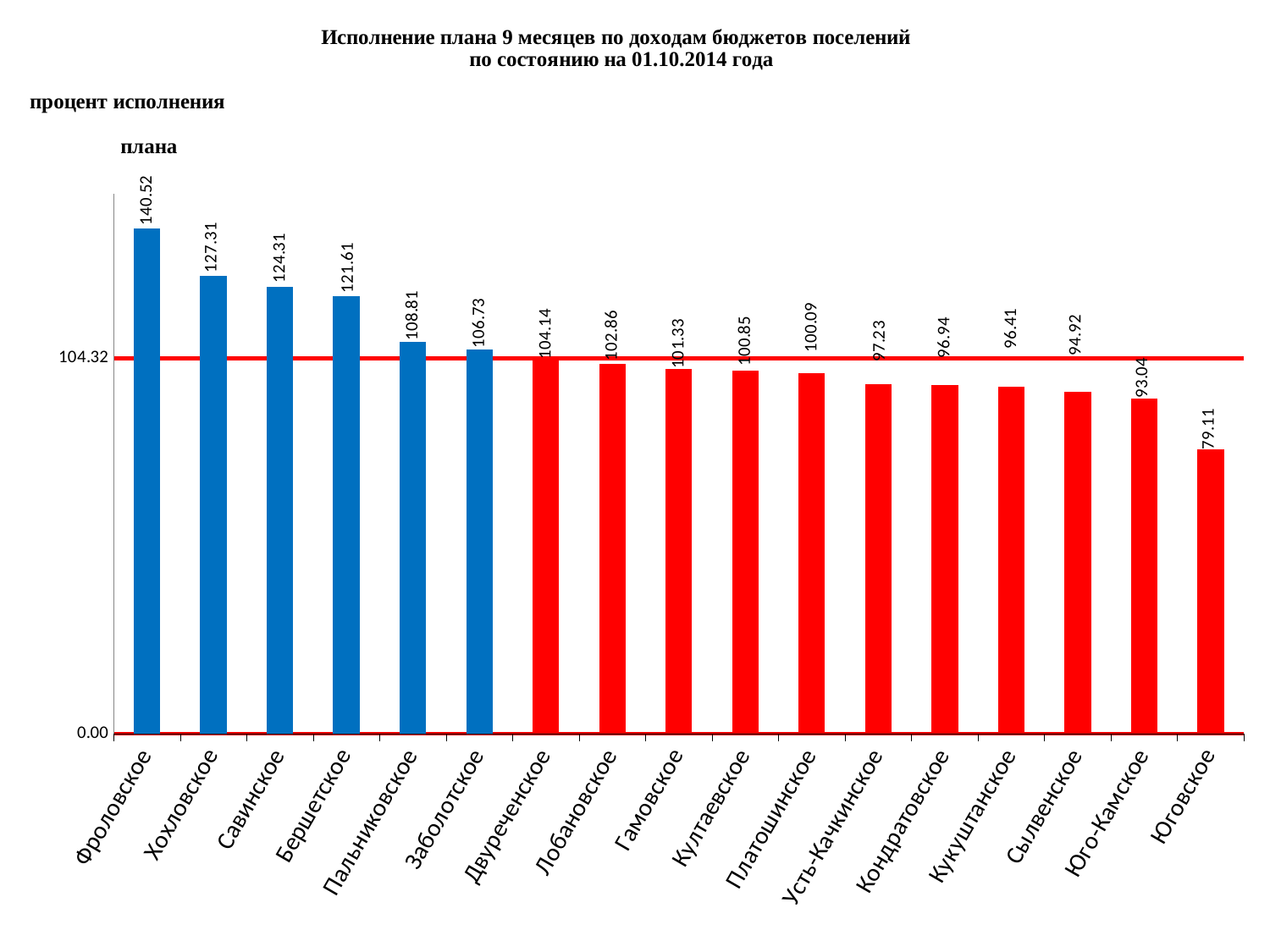
What is the difference between the values for Фроловское and Юговское? 61.41 What value is marked by the horizontal red line across the chart? 104.32 What is the value for Двуреченское? 104.14 How many categories are shown on the x axis? 17 Which category has the lowest value? Юговское What is the value for Фроловское? 140.52 What kind of chart is this? bar chart Which is larger, the value for Бершетское or the value for Пальниковское? Бершетское Which category has the highest value? Фроловское What is the difference between the values for Хохловское and Савинское? 3.00 What is the value for Юговское? 79.11 Do the values rise or fall from left to right along the x axis? fall